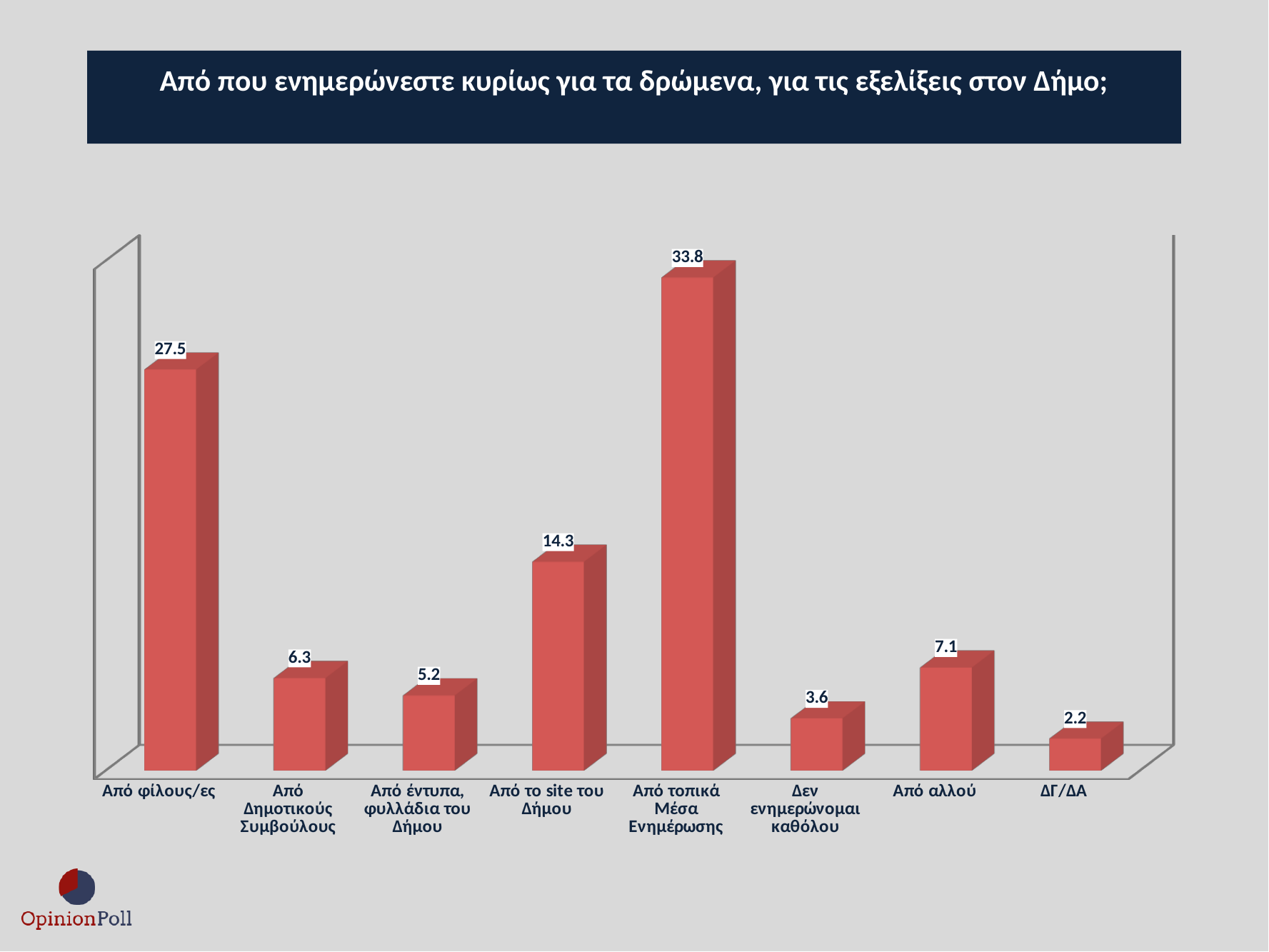
What is the title of the chart? Από που ενημερώνεστε κυρίως για τα δρώμενα, για τις εξελίξεις στον Δήμο; What is the value for 'Από φίλους/ες'? 27.5 What is the value for 'Από το site του Δήμου'? 14.3 What is the difference between the values for 'Από τοπικά Μέσα Ενημέρωσης' and 'Από φίλους/ες'? 6.3 What is the value for 'Από τοπικά Μέσα Ενημέρωσης'? 33.8 What is the value for 'Δεν ενημερώνομαι καθόλου'? 3.6 Which is larger, the value for 'Από αλλού' or the value for 'Από Δημοτικούς Συμβούλους'? Από αλλού Which category has the highest value? Από τοπικά Μέσα Ενημέρωσης How many categories are shown on the chart? 8 What is the difference between the values for 'Από Δημοτικούς Συμβούλους' and 'Από έντυπα, φυλλάδια του Δήμου'? 1.1 What kind of chart is shown on the slide? Bar chart Which category has the lowest value? ΔΓ/ΔΑ